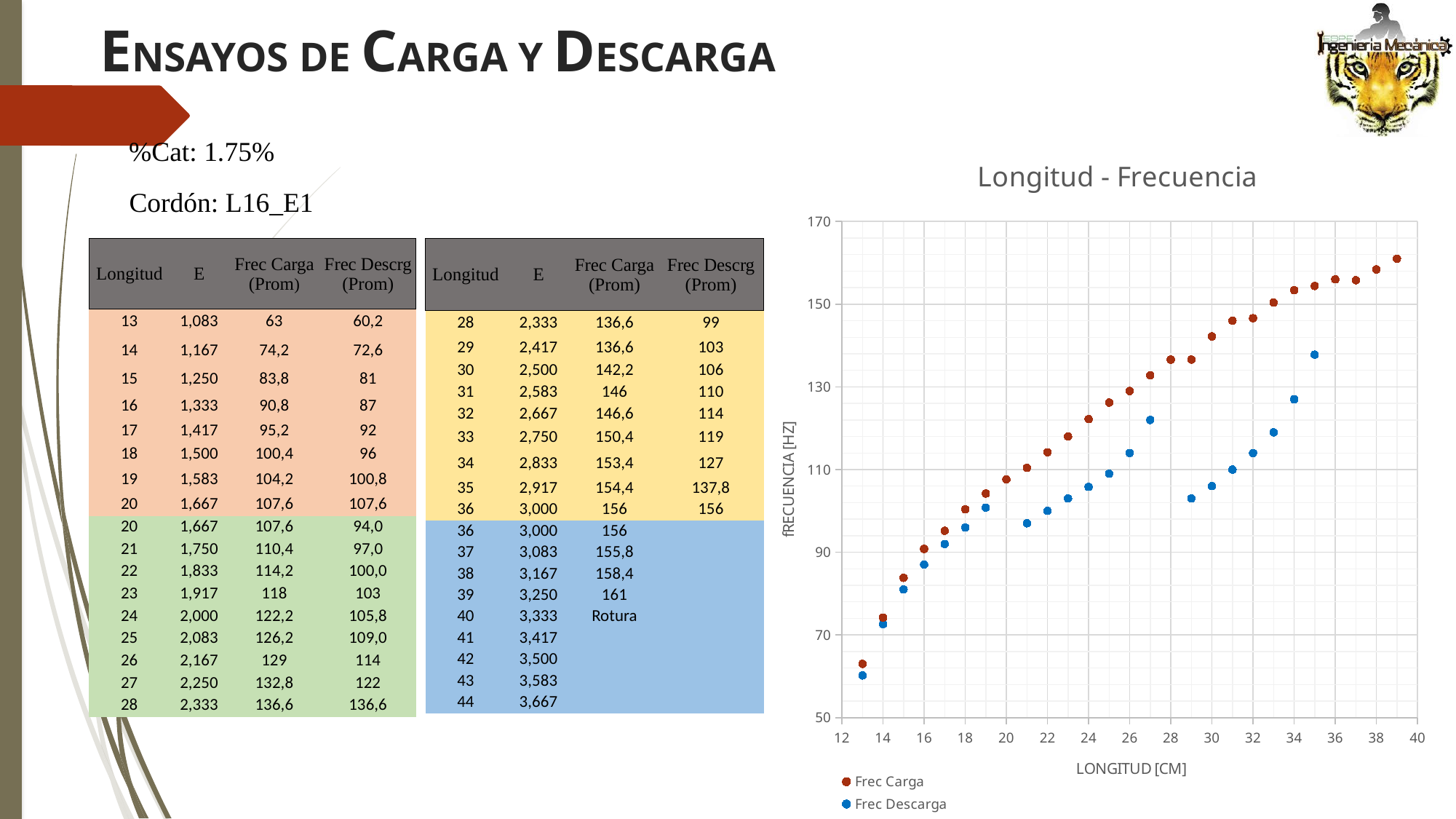
At 30 cm, which series has the higher frequency, Frec Carga or Frec Descarga? Frec Carga What kind of chart is shown on the slide? scatter chart What is the title of the chart? Longitud - Frecuencia Is the Frec Descarga value at 29 cm greater or less than 110? less What is the label of the chart's x axis? LONGITUD [CM] Is the Frec Descarga value at 13 cm greater or less than 70? less Is the Frec Carga value at 24 cm greater or less than 110? greater How many series does the chart legend list? 2 Do the Frec Carga values rise or fall as the length increases? rise At which length does the Frec Descarga series have its lowest frequency? 13 At which length does the Frec Carga series reach its highest frequency? 39